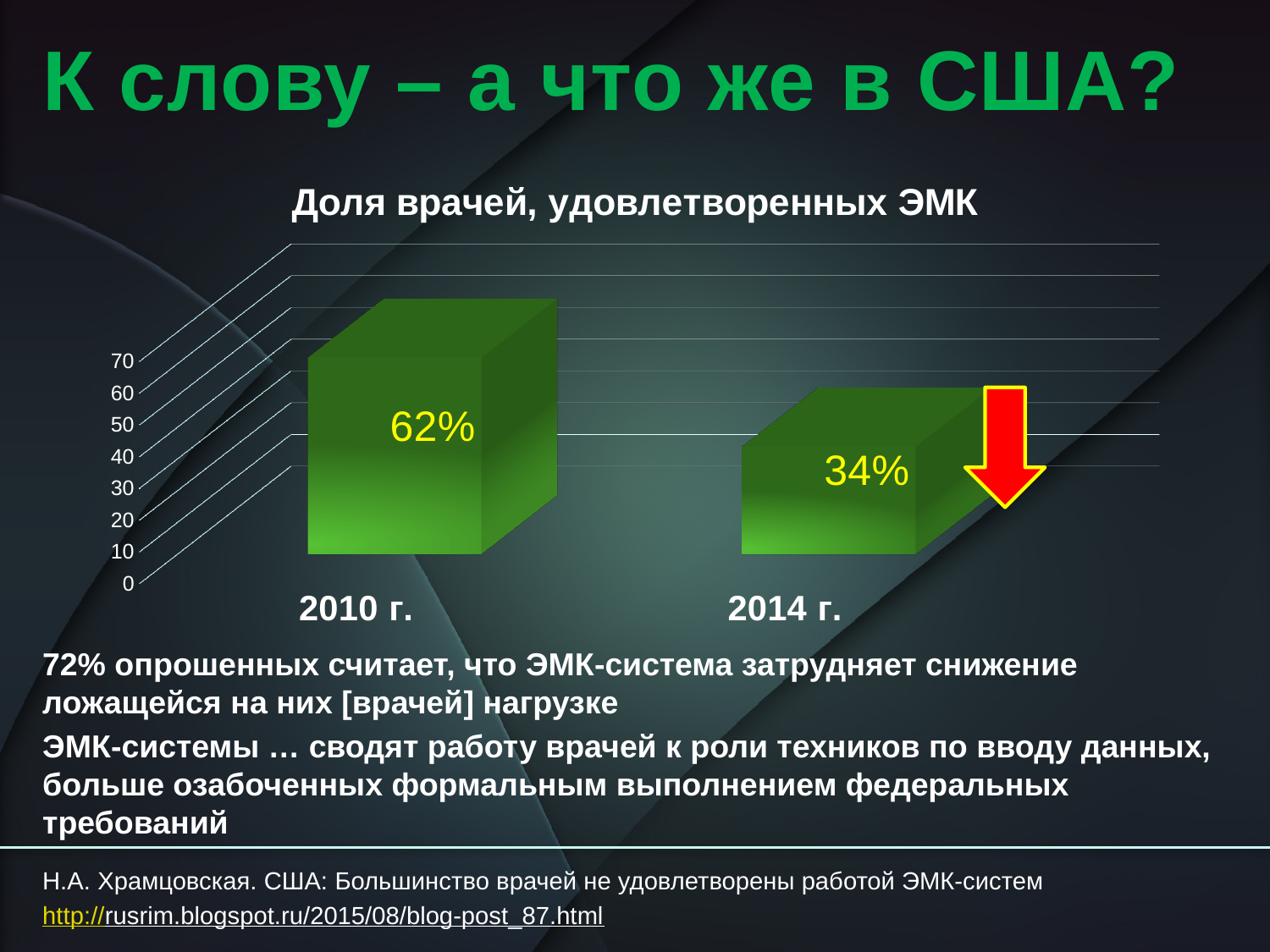
How many categories are shown on the x axis? 2 Is the value for 2014 г. greater or less than 50? less Which year has the higher share of doctors satisfied with ЭМК? 2010 г. What is the value for 2014 г.? 34% What is the title of the chart? Доля врачей, удовлетворенных ЭМК What is the value for 2010 г.? 62% What is the difference between the 2010 г. and 2014 г. values? 28% Do the values rise or fall from 2010 г. to 2014 г.? fall Is the value for 2010 г. larger or smaller than the value for 2014 г.? larger Is the value for 2010 г. greater or less than 60? greater What kind of chart is shown? bar chart Which year has the lower value? 2014 г.